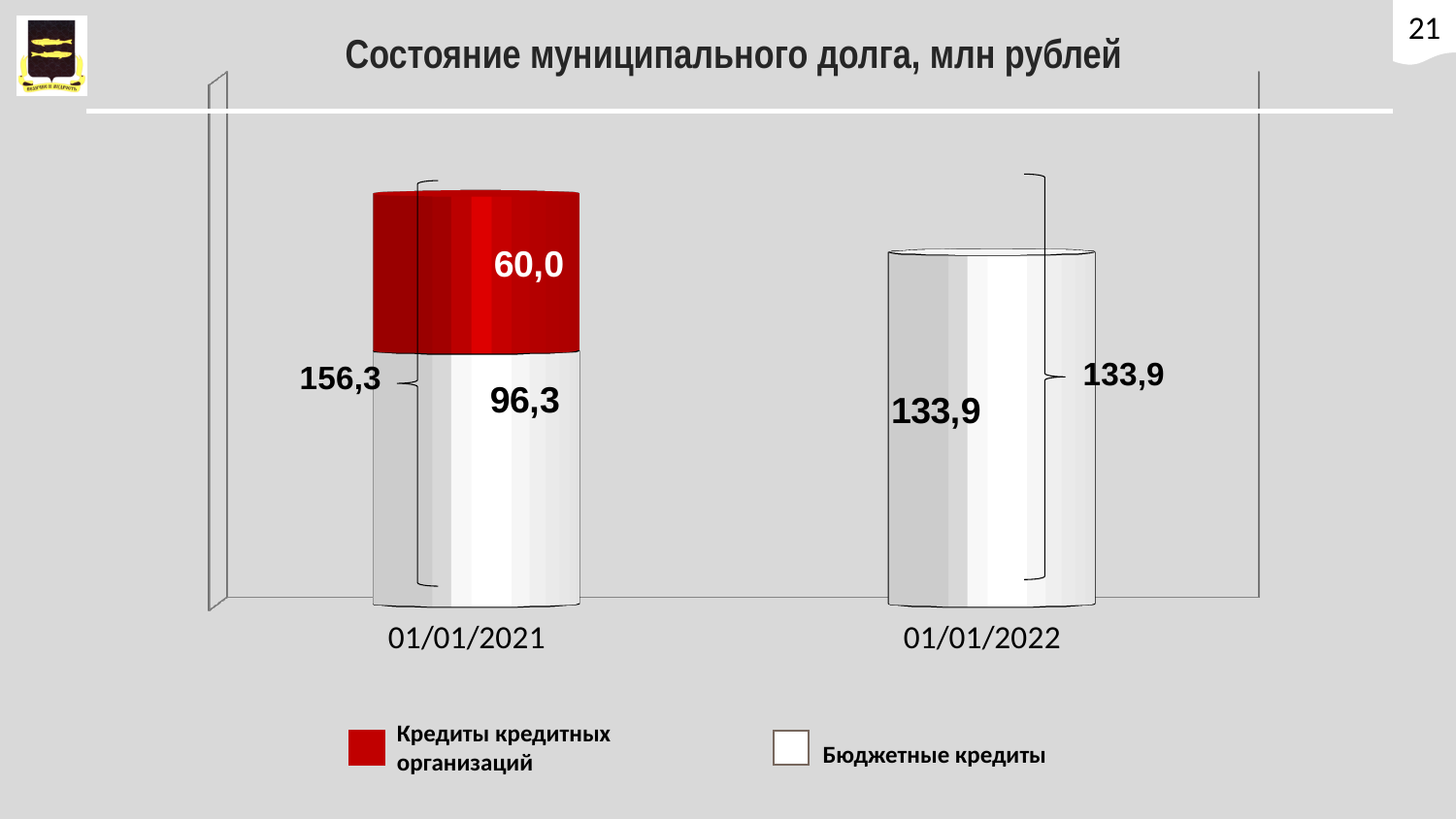
What is the value of Бюджетные кредиты for 01/01/2021? 96,3 Which colour represents Кредиты кредитных организаций in the legend? Red What is the total of the stacked bar for 01/01/2022? 133,9 What is the total of the stacked bar for 01/01/2021? 156,3 What is the title of the chart? Состояние муниципального долга, млн рублей What kind of chart is shown on the slide? Stacked bar chart What is the value of Кредиты кредитных организаций for 01/01/2021? 60,0 How many categories are shown on the x axis? 2 What is the value of Бюджетные кредиты for 01/01/2022? 133,9 How many series does the legend list? 2 Which date has the higher total municipal debt? 01/01/2021 What is the difference between the total for 01/01/2021 and the total for 01/01/2022? 22,4